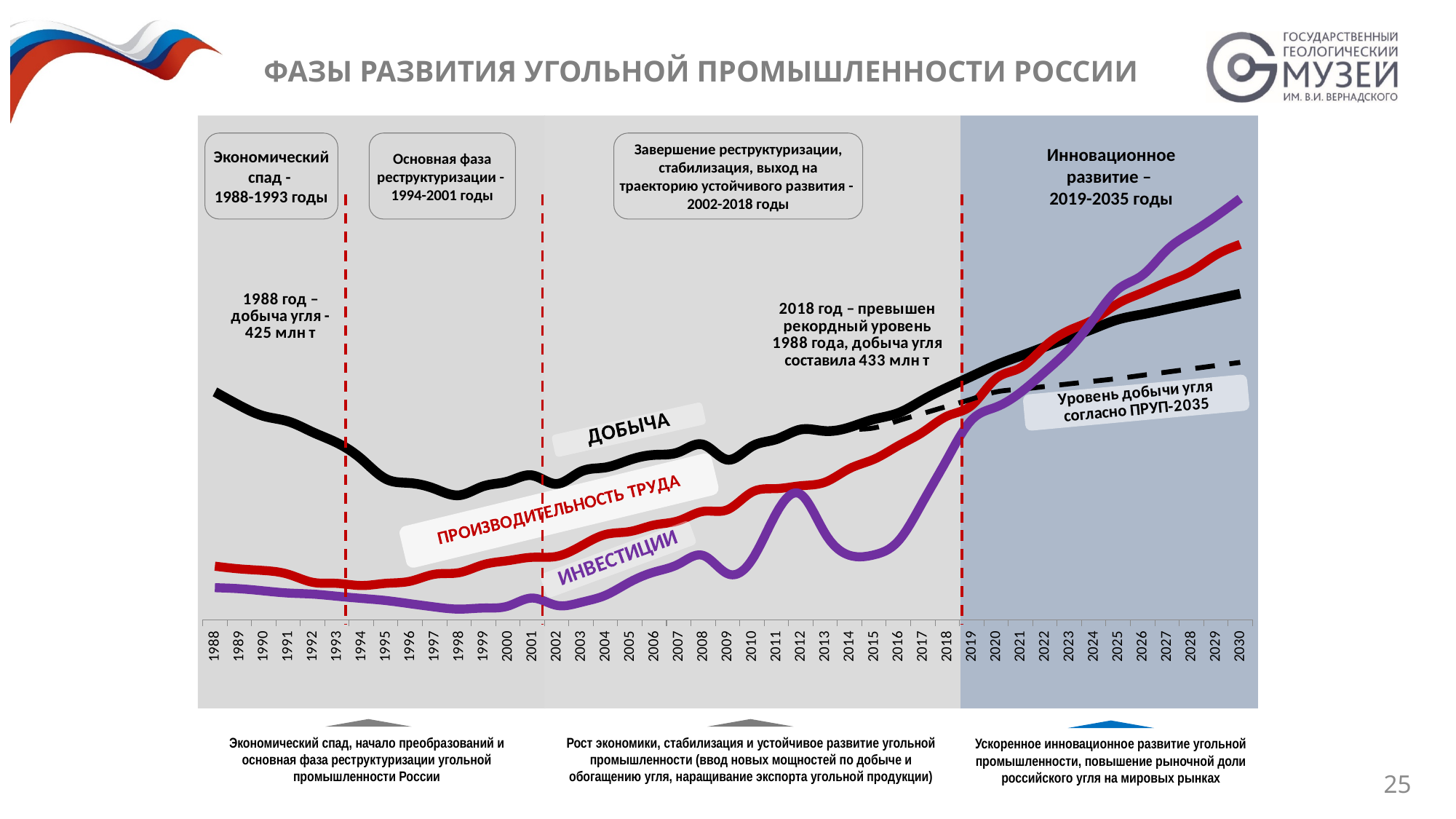
Does the ДОБЫЧА line rise or fall between 1988 and 1998? fall How many years are marked on the x axis of the chart? 43 By how much did coal production in 2018 exceed the 1988 level, according to the annotated values? 8 млн т According to the annotation on the chart, what was coal production (добыча угля) in 2018? 433 млн т How many labelled solid line series are plotted on the chart? 3 Does the ИНВЕСТИЦИИ line rise or fall between 2019 and 2030? rise What is the title of the slide containing the chart? ФАЗЫ РАЗВИТИЯ УГОЛЬНОЙ ПРОМЫШЛЕННОСТИ РОССИИ What is the first year shown on the x axis of the chart? 1988 Which annotated coal production value is larger: 1988 or 2018? 2018 According to the annotation on the chart, what was coal production (добыча угля) in 1988? 425 млн т What kind of chart is shown on the slide? line chart What is the last year shown on the x axis of the chart? 2030